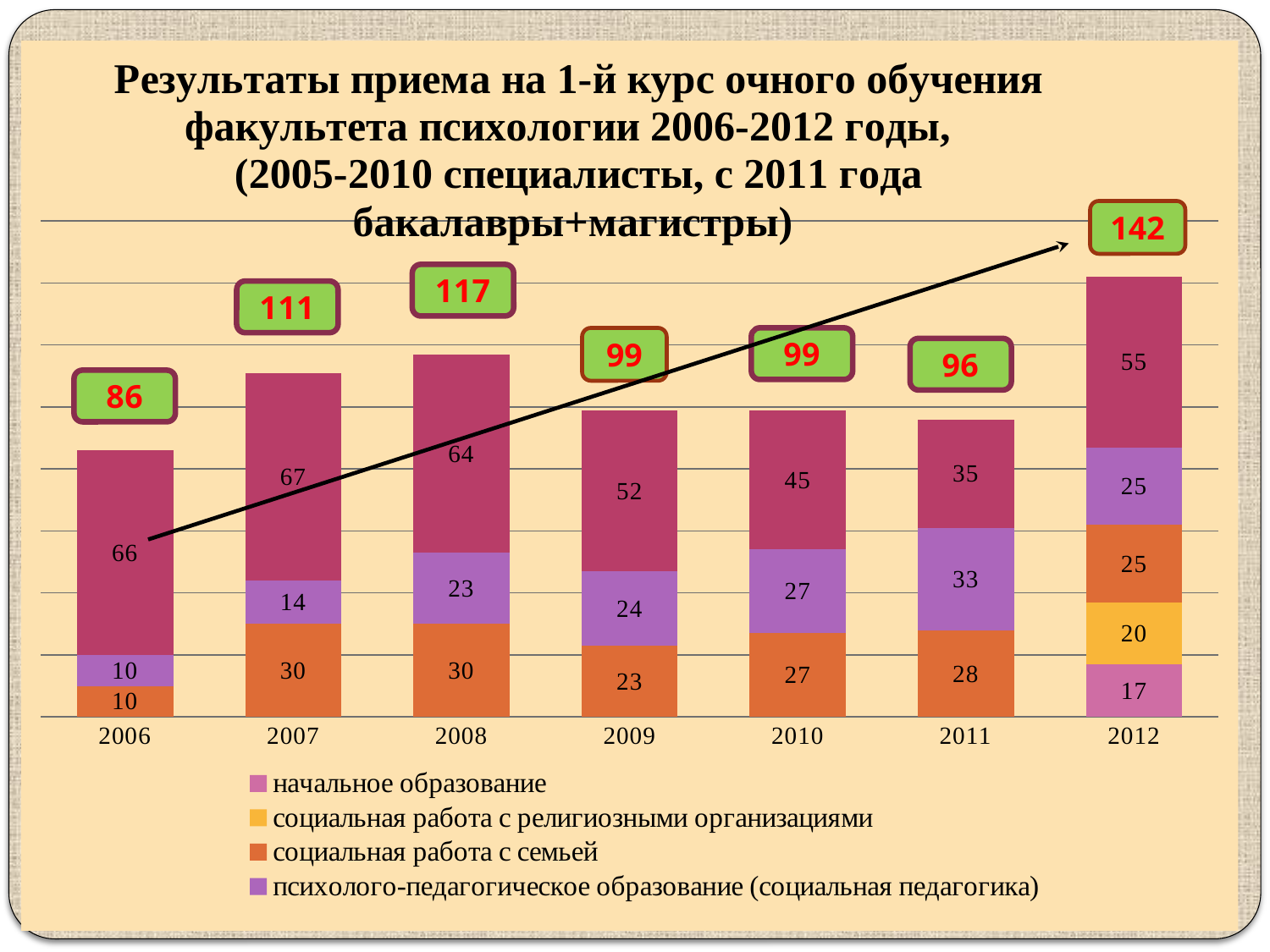
What is the value for психолого-педагогическое образование (социальная педагогика) in 2011? 33 What kind of chart is shown on the slide? Stacked bar chart What is the total shown for the 2012 bar? 142 How many years are shown on the x axis? 7 What is the difference between the total for 2012 and the total for 2006? 56 Which is larger: психолого-педагогическое образование (социальная педагогика) in 2011 or in 2010? 2011 Which year has the lowest total admissions? 2006 What is the value for социальная работа с религиозными организациями in 2012? 20 How many series does the legend list? 4 What is the value for социальная работа с семьей in 2008? 30 Which year has the highest total admissions? 2012 What is the value for начальное образование in 2012? 17